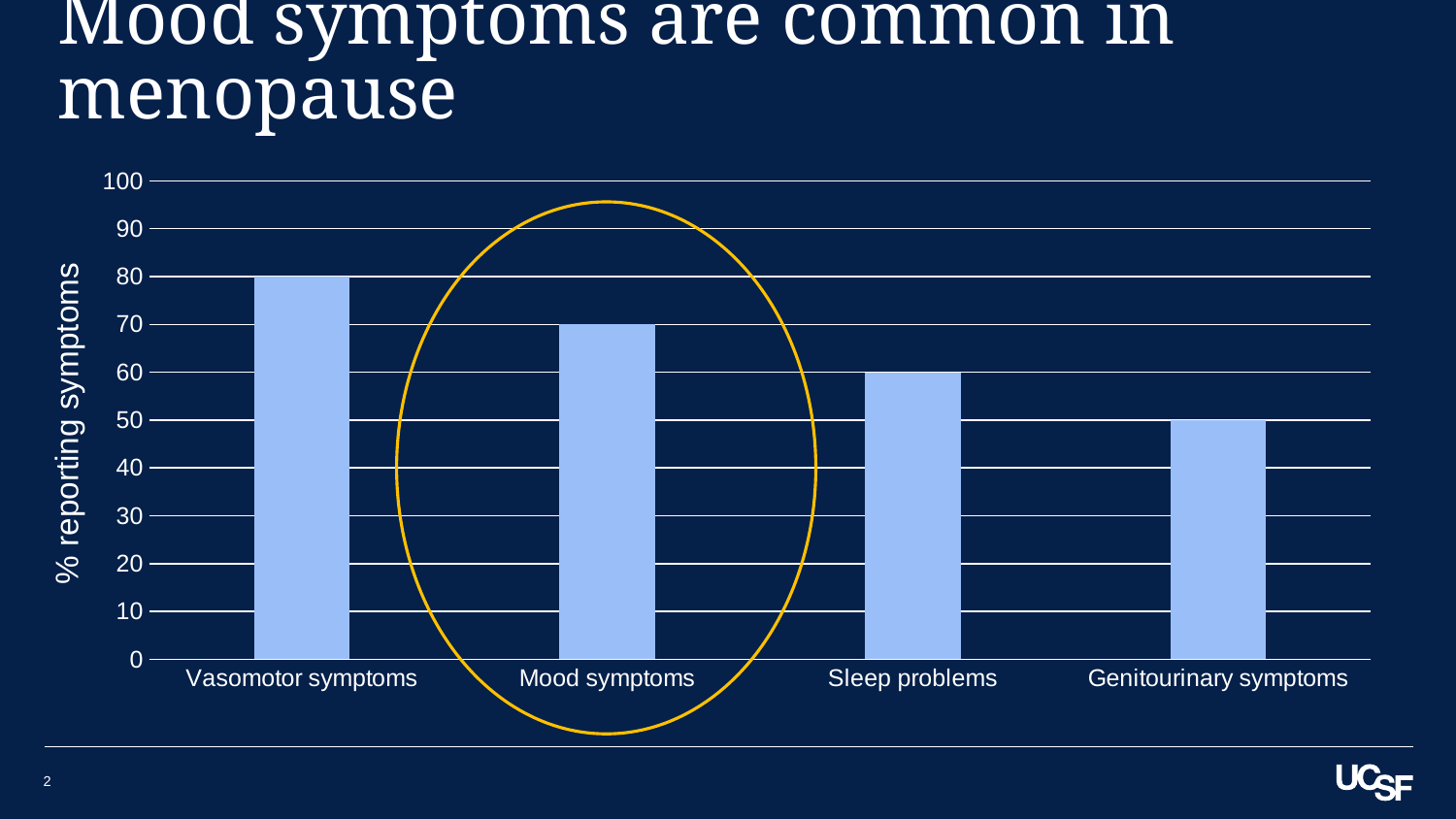
Do the values rise or fall from left to right along the x axis? Fall What percentage is shown for Vasomotor symptoms? 80 What kind of chart is shown on the slide? Bar chart Which is larger, the value for Mood symptoms or the value for Sleep problems? Mood symptoms What is the difference between the values for Vasomotor symptoms and Genitourinary symptoms? 30 Which category is circled on the chart? Mood symptoms What percentage is shown for Genitourinary symptoms? 50 Which category has the highest value? Vasomotor symptoms How many categories are shown on the x axis? 4 What percentage is shown for Sleep problems? 60 What percentage is shown for Mood symptoms? 70 Which category has the lowest value? Genitourinary symptoms